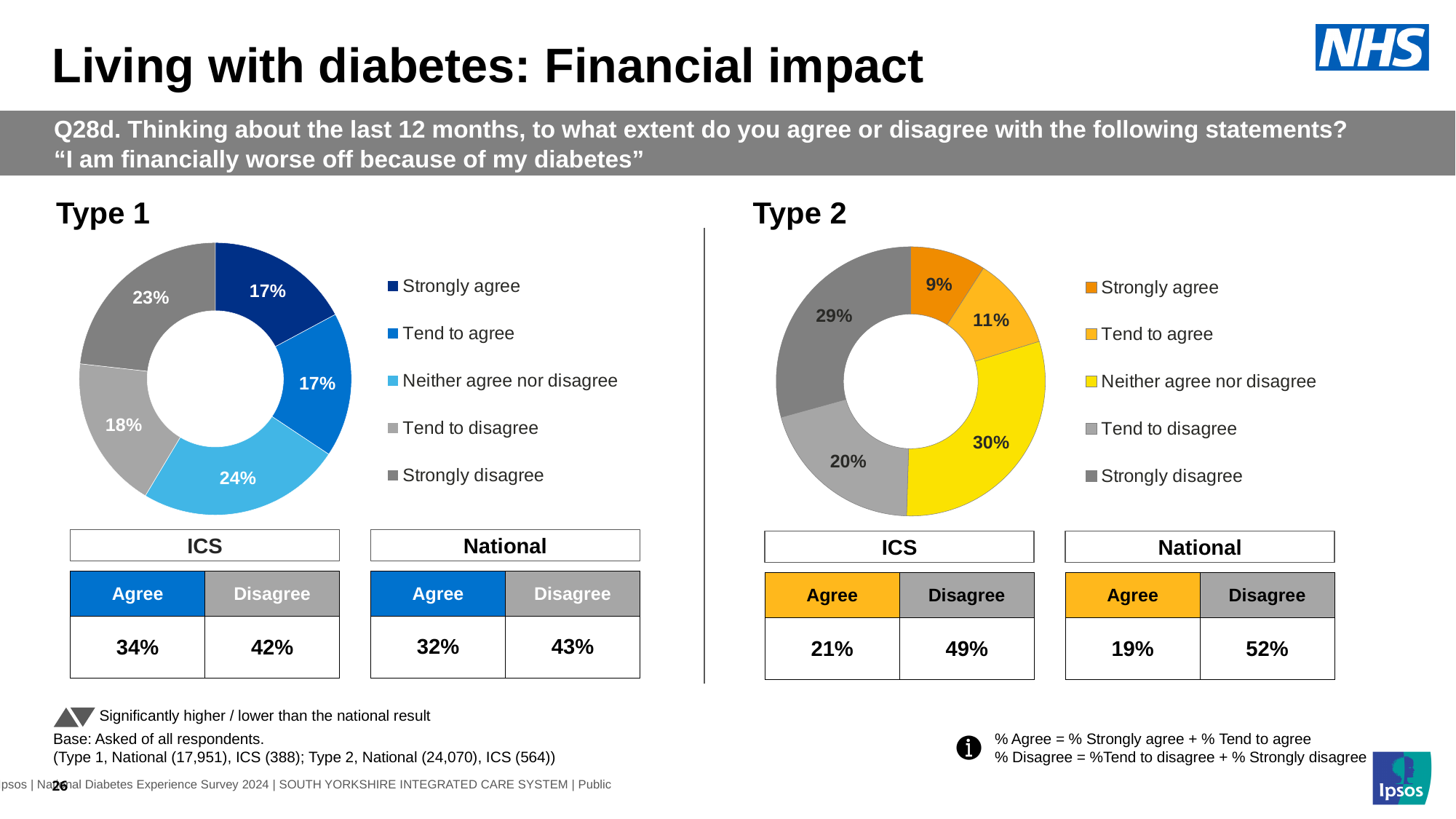
In the Type 2 chart, what percentage of respondents said 'Tend to disagree'? 20% In the Type 2 chart, which is larger: the 'Strongly disagree' share or the 'Tend to disagree' share? Strongly disagree How many response categories does the legend of the Type 1 chart list? 5 In the Type 2 chart, what is the difference between the 'Strongly disagree' share and the 'Tend to agree' share? 18% In the Type 1 chart, what percentage of respondents said 'Neither agree nor disagree'? 24% What kind of chart is used to show the Type 2 results? Pie (donut) chart In the Type 2 chart, which response category has the smallest share? Strongly agree In the Type 2 chart, what percentage of respondents said 'Strongly agree'? 9% In the Type 1 chart, what is the difference between the 'Neither agree nor disagree' share and the 'Tend to disagree' share? 6% In the Type 1 chart, which response category has the largest share? Neither agree nor disagree In the Type 1 chart, what percentage of respondents said 'Strongly disagree'? 23% In the Type 2 chart, which response category has the largest share? Neither agree nor disagree